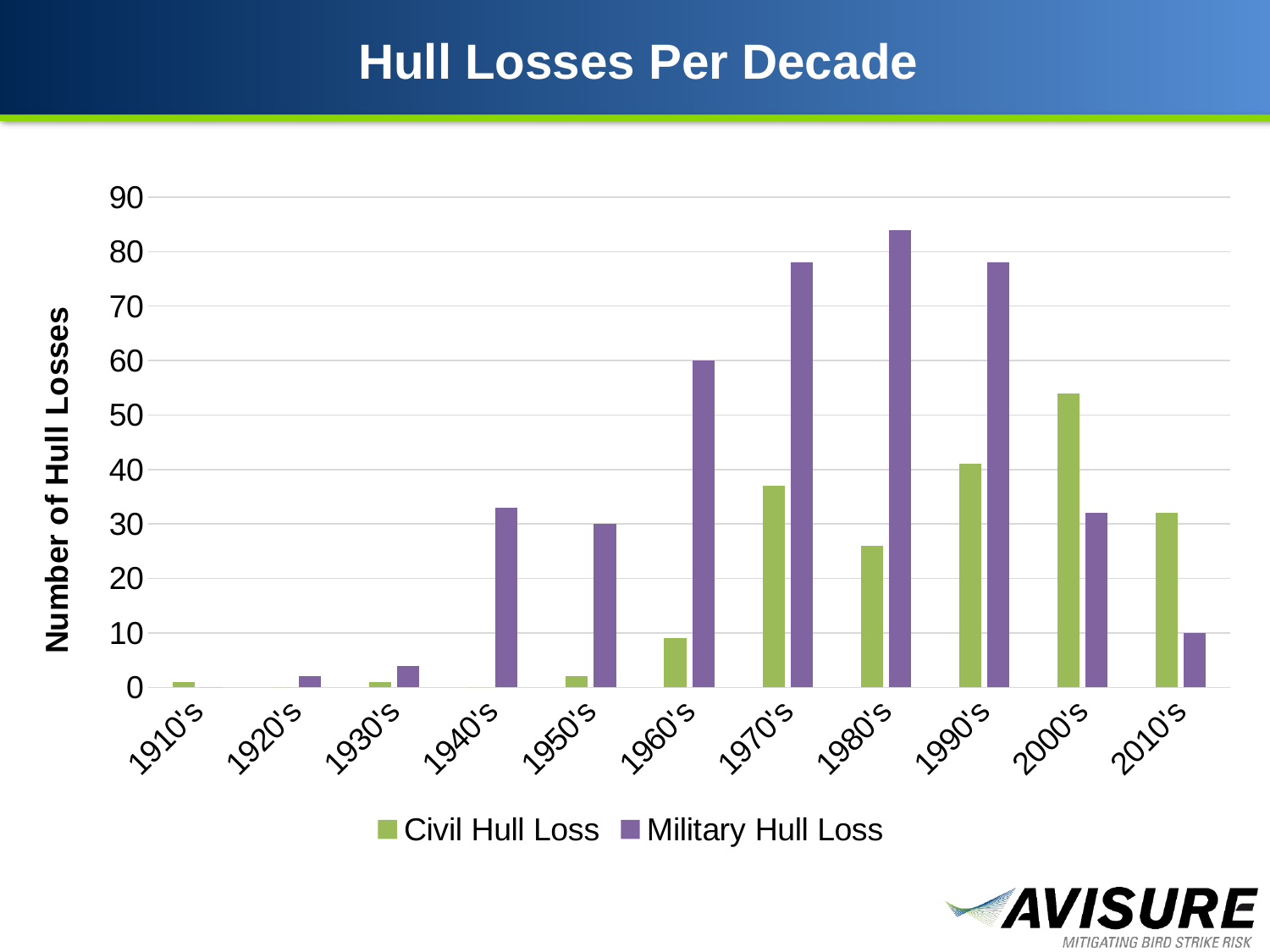
In the 1970's, which is larger: Civil Hull Loss or Military Hull Loss? Military Hull Loss Which decade has the highest Civil Hull Loss? 2000's Which colour represents Military Hull Loss in the legend? purple What is the Military Hull Loss value for the 1960's? 60 How many decades are shown on the x axis? 11 Is the Military Hull Loss value for the 1980's greater or less than 80? greater What type of chart is shown on the slide? bar chart Is the Civil Hull Loss value for the 2000's greater or less than 50? greater Which decade has the highest Military Hull Loss? 1980's In the 2000's, which is larger: Civil Hull Loss or Military Hull Loss? Civil Hull Loss What is the Military Hull Loss value for the 2010's? 10 How many series does the legend list? 2